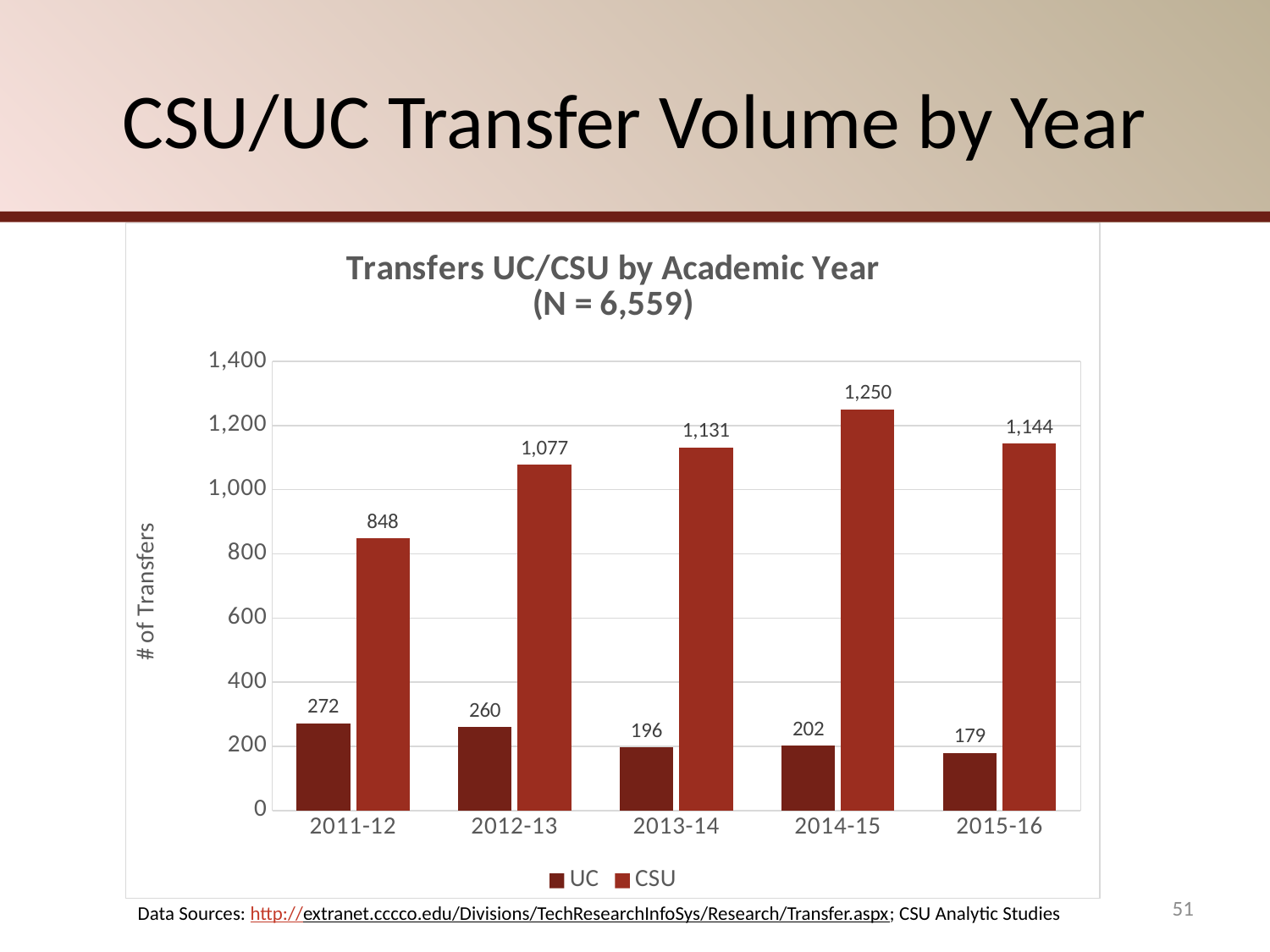
Which academic year has the lowest number of UC transfers? 2015-16 What is the number of CSU transfers in 2014-15? 1,250 What is the total number of transfers (UC plus CSU) in 2015-16? 1,323 How many series does the legend list? 2 What is the difference between CSU and UC transfers in 2013-14? 935 What kind of chart is shown on the slide? Bar chart What is the number of CSU transfers in 2012-13? 1,077 Which academic year has the highest number of CSU transfers? 2014-15 How many academic years are shown on the x axis? 5 Which is larger, UC transfers in 2012-13 or UC transfers in 2014-15? UC transfers in 2012-13 What is the title of the chart? Transfers UC/CSU by Academic Year (N = 6,559) What is the number of UC transfers in 2011-12? 272